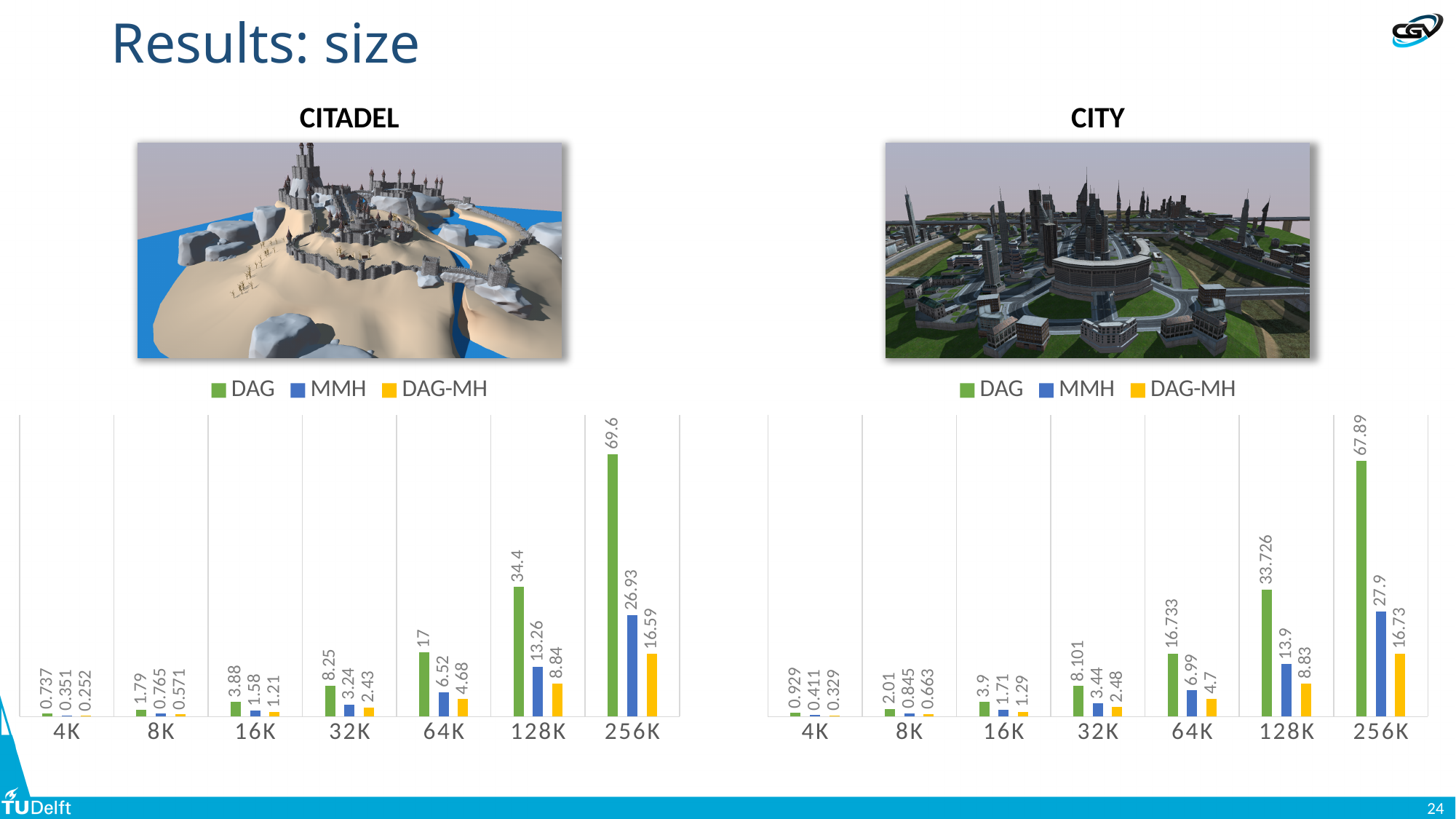
In the CITADEL chart, does the DAG value rise or fall as the size increases from 4K to 256K? rise In the CITY chart, which series has the lowest value at 256K? DAG-MH How many size categories are shown on the x axis of the CITY chart? 7 In the CITADEL chart, what is the DAG value at 256K? 69.6 In the CITADEL chart, which series has the highest value at 128K? DAG In the CITADEL chart, what is the DAG-MH value at 64K? 4.68 Which is larger: the DAG value at 256K in the CITADEL chart or the DAG value at 256K in the CITY chart? CITADEL In the CITY chart, what is the DAG value at 32K? 8.101 In the CITADEL chart, what is the difference between the DAG and MMH values at 256K? 42.67 In the CITY chart, what is the difference between the MMH and DAG-MH values at 256K? 11.17 How many series does the legend of the CITADEL chart list? 3 In the CITY chart, what is the MMH value at 128K? 13.9